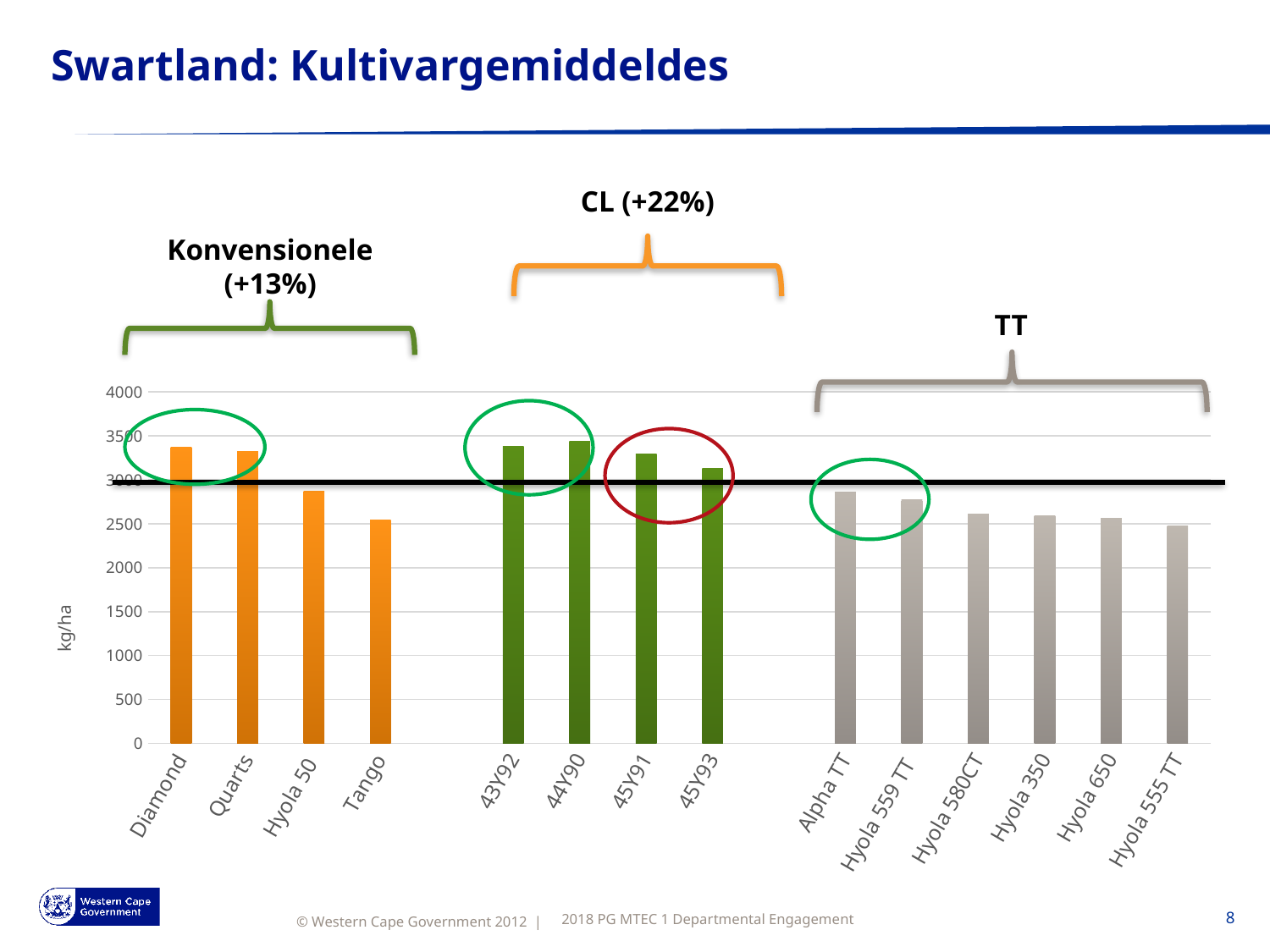
Which has the larger value, Diamond or Tango? Diamond Is the value for Diamond greater or less than 3000? greater What is the label on the vertical axis of the chart? kg/ha Which has the larger value, Hyola 50 or Hyola 580CT? Hyola 50 Is the value for Alpha TT greater or less than 3000? less What percentage is shown next to the 'CL' group label above the chart? +22% How many cultivars (bars) are plotted in the chart? 14 Is the value for Tango greater or less than 3000? less What kind of chart is shown on the slide? bar chart Within the TT group, do the values rise or fall from Alpha TT to Hyola 555 TT? fall